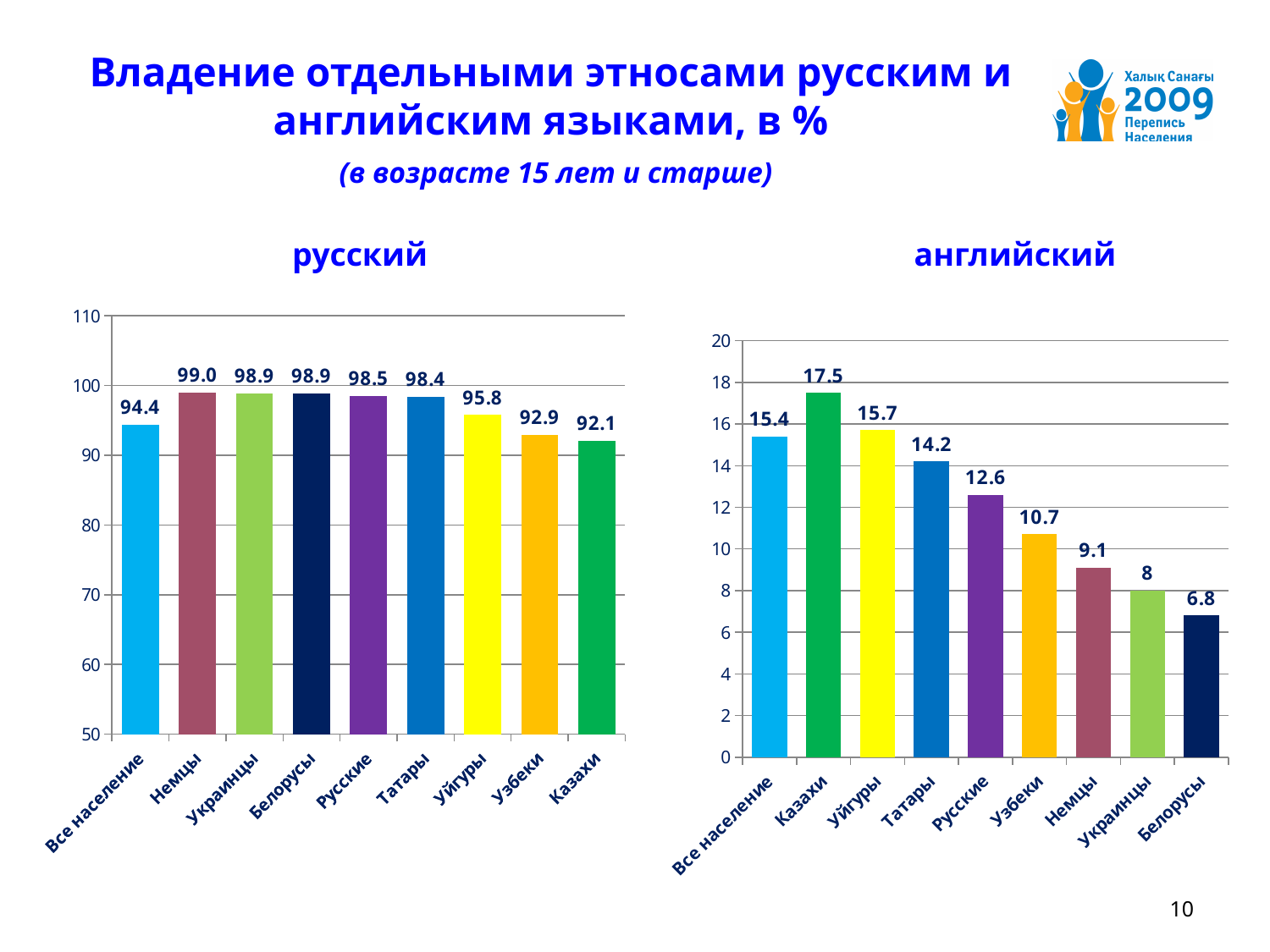
In the 'русский' chart, which category has the lowest value? Казахи In the 'английский' chart, which category has the lowest value? Белорусы How many categories are shown in the 'русский' chart? 9 In the 'английский' chart, what is the value for Татары? 14.2 In the 'русский' chart, what is the difference between the values for Немцы and Казахи? 6.9 In the 'русский' chart, which is larger, the value for Уйгуры or the value for Узбеки? Уйгуры What kind of chart is the 'английский' chart? bar chart In the 'английский' chart, which category has the highest value? Казахи In the 'английский' chart, is the value for Русские greater or less than 10? greater In the 'русский' chart, what is the value for Немцы? 99.0 In the 'английский' chart, do the values rise or fall from Казахи to Белорусы along the x axis? fall In the 'английский' chart, what is the difference between the values for Казахи and Белорусы? 10.7